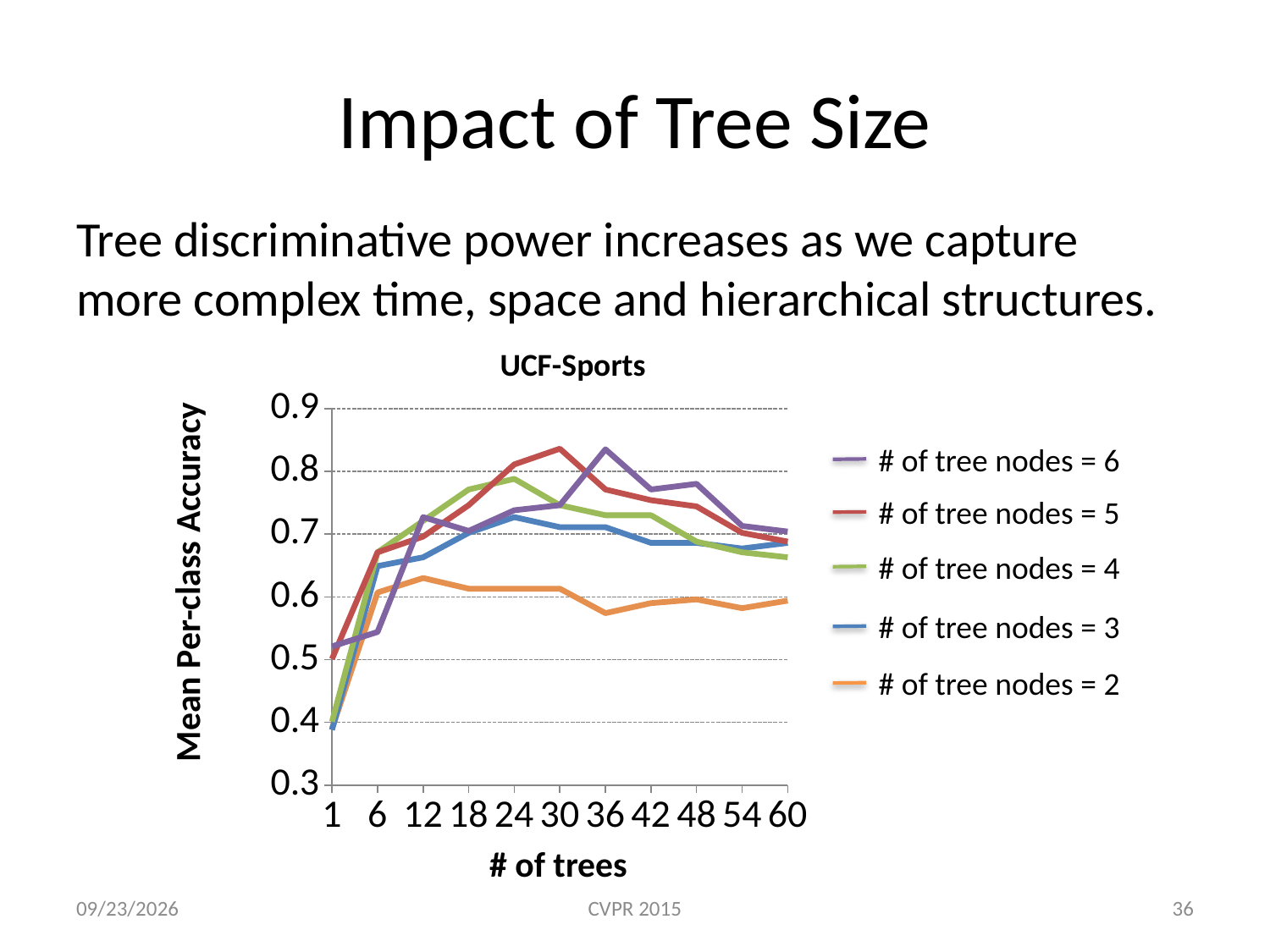
What is the title of the chart? UCF-Sports At 60 trees, which is larger: the value for '# of tree nodes = 5' or '# of tree nodes = 2'? # of tree nodes = 5 How many points are on the x axis (# of trees)? 11 Is the value for '# of tree nodes = 2' at 36 trees greater or less than 0.6? less What kind of chart is shown on the slide? line chart Is the value for '# of tree nodes = 3' at 1 tree greater or less than 0.5? less Is the value for '# of tree nodes = 5' at 30 trees greater or less than 0.8? greater Does the value for '# of tree nodes = 5' rise or fall from 30 trees to 60 trees? fall Which series has the lowest value at 60 trees? # of tree nodes = 2 Which series has the highest value at 30 trees? # of tree nodes = 5 How many series does the legend list? 5 What is the label of the y axis? Mean Per-class Accuracy